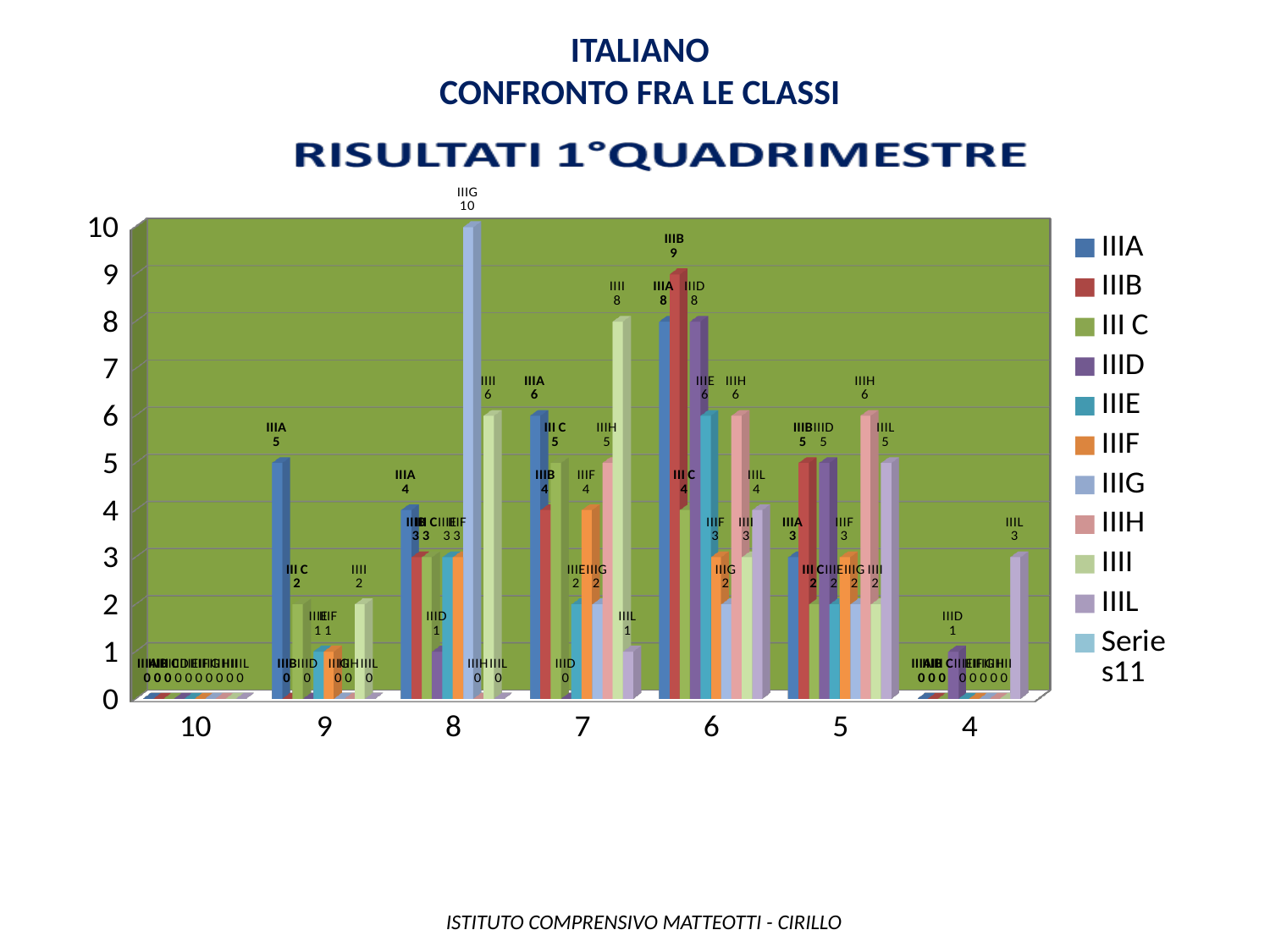
How many series does the legend list? 11 What kind of chart is shown on the slide? bar chart How many categories are shown on the x axis? 7 What is the value for IIIL at category 4? 3 What is the value for IIIA at category 9? 5 At category 7, which is larger: the value for IIIA or the value for IIIB? IIIA What is the value for IIIB at category 6? 9 What is the difference between the IIIB and IIIA values at category 6? 1 What is the value for IIIG at category 8? 10 Which series has the highest value at category 8? IIIG What is the value for IIII at category 7? 8 What is the title of the chart? RISULTATI 1°QUADRIMESTRE